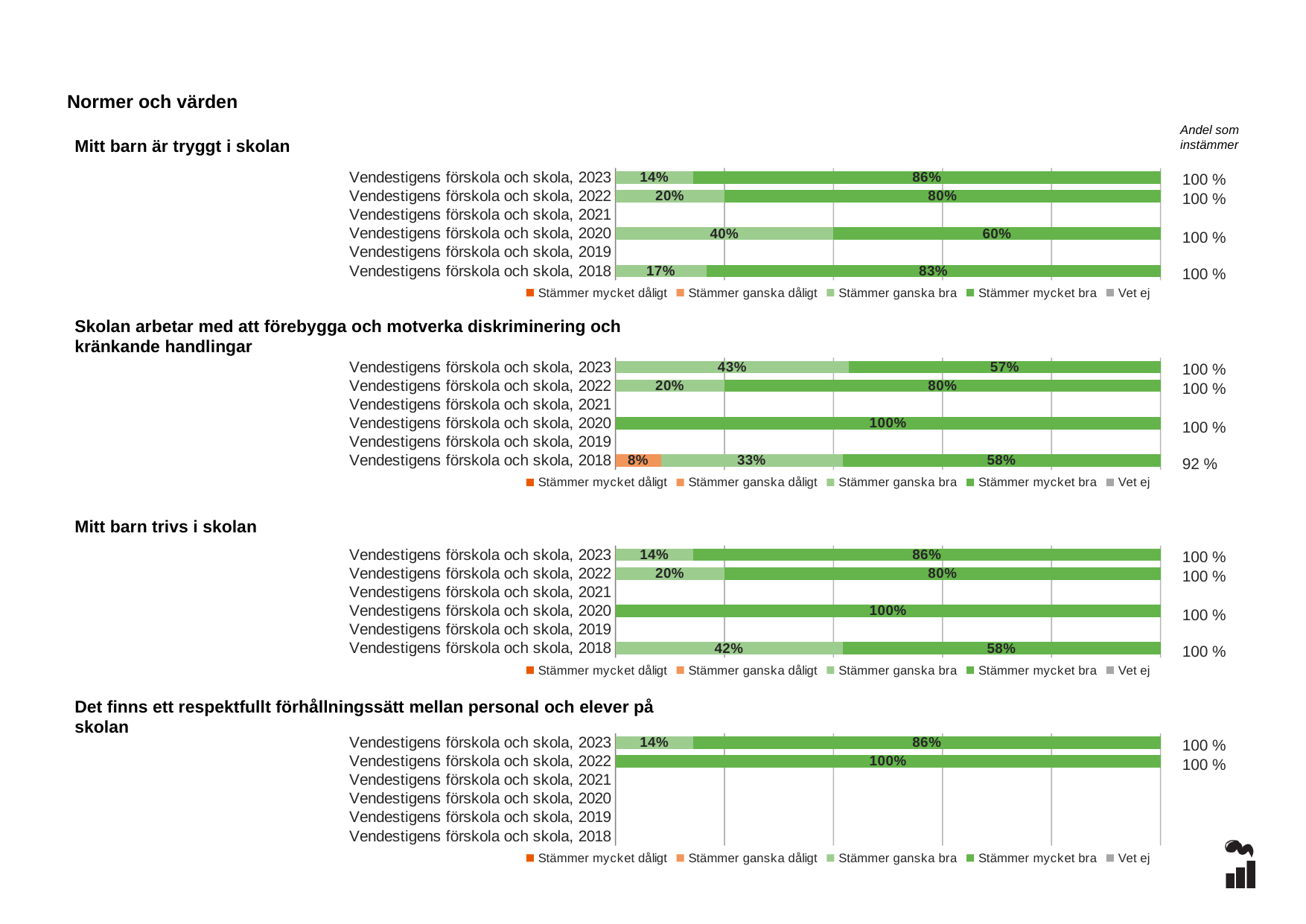
In the chart 'Skolan arbetar med att förebygga och motverka diskriminering och kränkande handlingar', what is the value for 'Stämmer ganska dåligt' for Vendestigens förskola och skola, 2018? 8% In the chart 'Skolan arbetar med att förebygga och motverka diskriminering och kränkande handlingar', what is the 'Andel som instämmer' for Vendestigens förskola och skola, 2018? 92 % In the chart 'Mitt barn är tryggt i skolan', what is the value for 'Stämmer mycket bra' for Vendestigens förskola och skola, 2023? 86% In the chart 'Skolan arbetar med att förebygga och motverka diskriminering och kränkande handlingar', is the 'Stämmer mycket bra' value larger for 2022 or 2023? 2022 How many categories are listed on the axis of the chart 'Det finns ett respektfullt förhållningssätt mellan personal och elever på skolan'? 6 In the chart 'Mitt barn är tryggt i skolan', which year has the highest 'Stämmer mycket bra' value? 2023 In the chart 'Mitt barn är tryggt i skolan', what is the difference between the 'Stämmer mycket bra' values for 2023 and 2020? 26% In the chart 'Det finns ett respektfullt förhållningssätt mellan personal och elever på skolan', what is the value for 'Stämmer mycket bra' for Vendestigens förskola och skola, 2022? 100% In the chart 'Mitt barn trivs i skolan', what is the value for 'Stämmer mycket bra' for Vendestigens förskola och skola, 2018? 58% In the chart 'Mitt barn är tryggt i skolan', what is the value for 'Stämmer ganska bra' for Vendestigens förskola och skola, 2020? 40% What kind of chart is 'Mitt barn trivs i skolan'? Stacked bar chart How many series does the legend list in the chart 'Mitt barn trivs i skolan'? 5